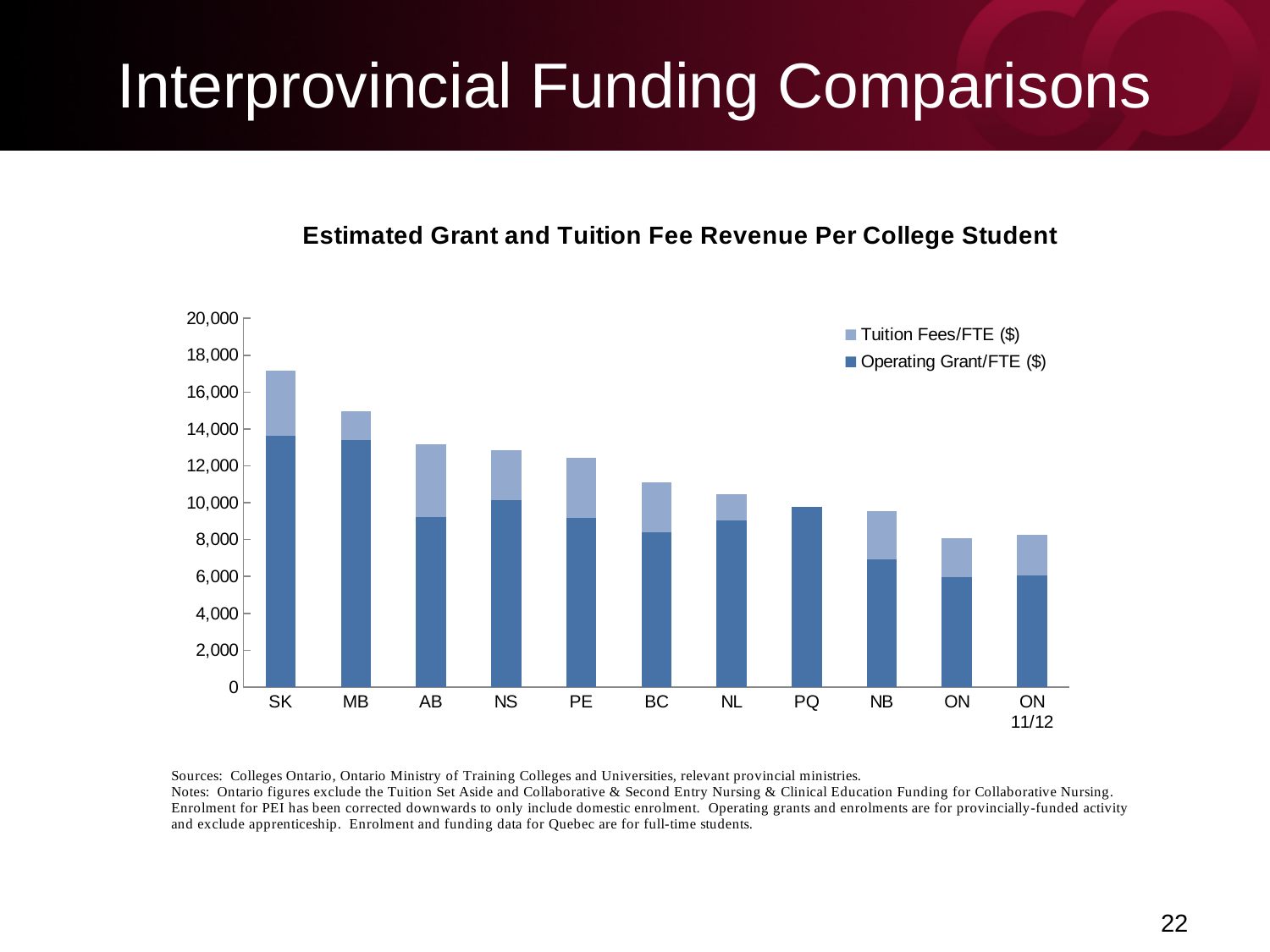
How many provinces/categories are shown along the x axis of the chart? 11 Which has the larger total bar, SK or MB? SK Is the Operating Grant/FTE value for NB greater or less than 8,000? less Is the total bar for SK greater or less than 16,000? greater What kind of chart is shown on the slide? Stacked bar chart What is the title of the chart? Estimated Grant and Tuition Fee Revenue Per College Student How many series does the chart's legend list? 2 Is the Operating Grant/FTE value for MB greater or less than 12,000? greater Which has the larger Operating Grant/FTE value, AB or NS? NS Do the total bar heights generally rise or fall moving from left to right across the x axis? fall Which category has the highest total grant and tuition fee revenue per student? SK